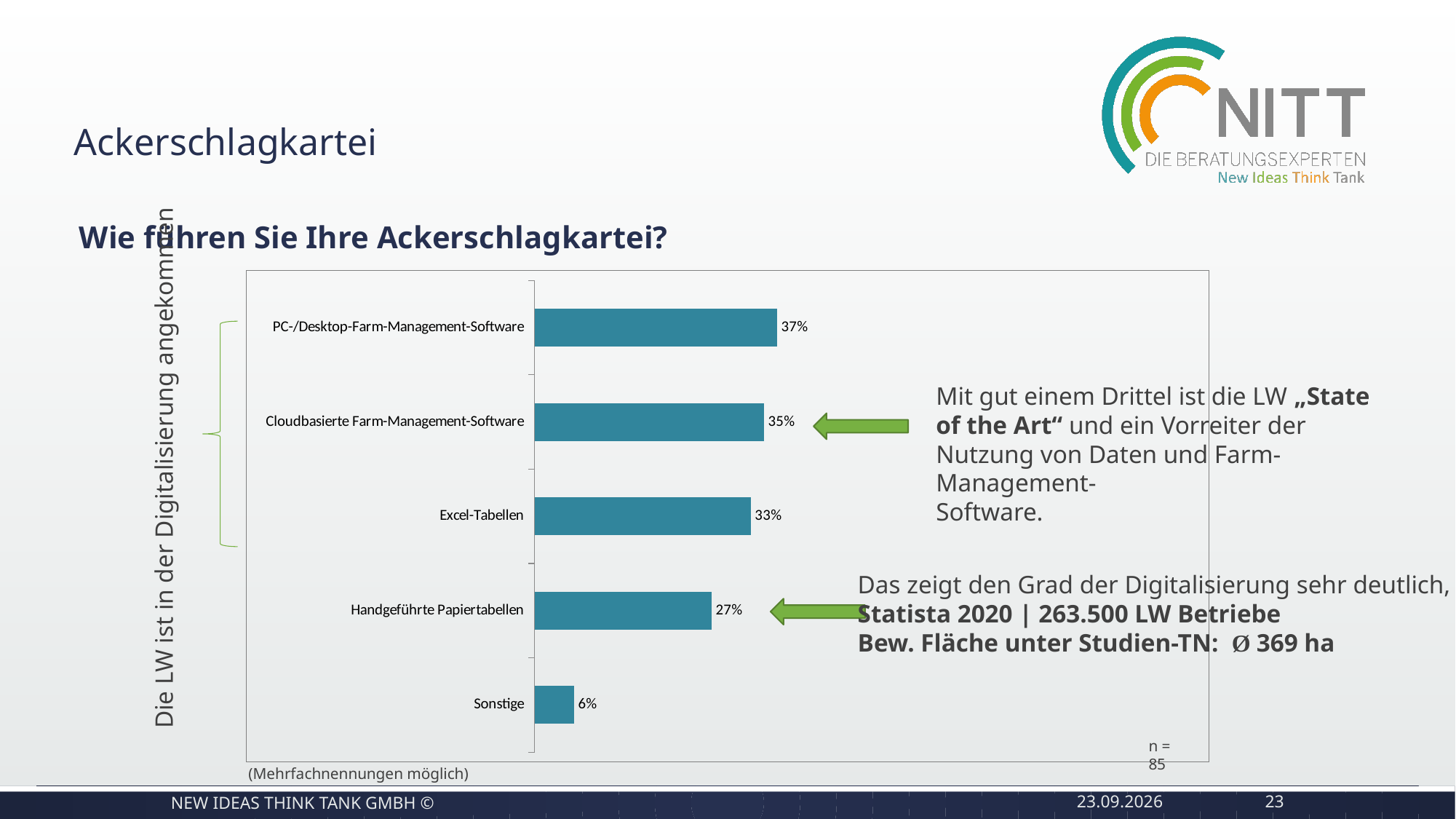
What kind of chart is shown on the slide? Bar chart What is the value for Handgeführte Papiertabellen? 27% What is the value for Sonstige? 6% What is the value for Excel-Tabellen? 33% Which category has the highest value? PC-/Desktop-Farm-Management-Software How many categories are shown in the chart? 5 What is the difference between the values for PC-/Desktop-Farm-Management-Software and Handgeführte Papiertabellen? 10% Which category has the lowest value? Sonstige Which is larger: the value for Excel-Tabellen or the value for Handgeführte Papiertabellen? Excel-Tabellen What is the sample size (n) stated on the chart? 85 What is the value for Cloudbasierte Farm-Management-Software? 35% What is the value for PC-/Desktop-Farm-Management-Software? 37%